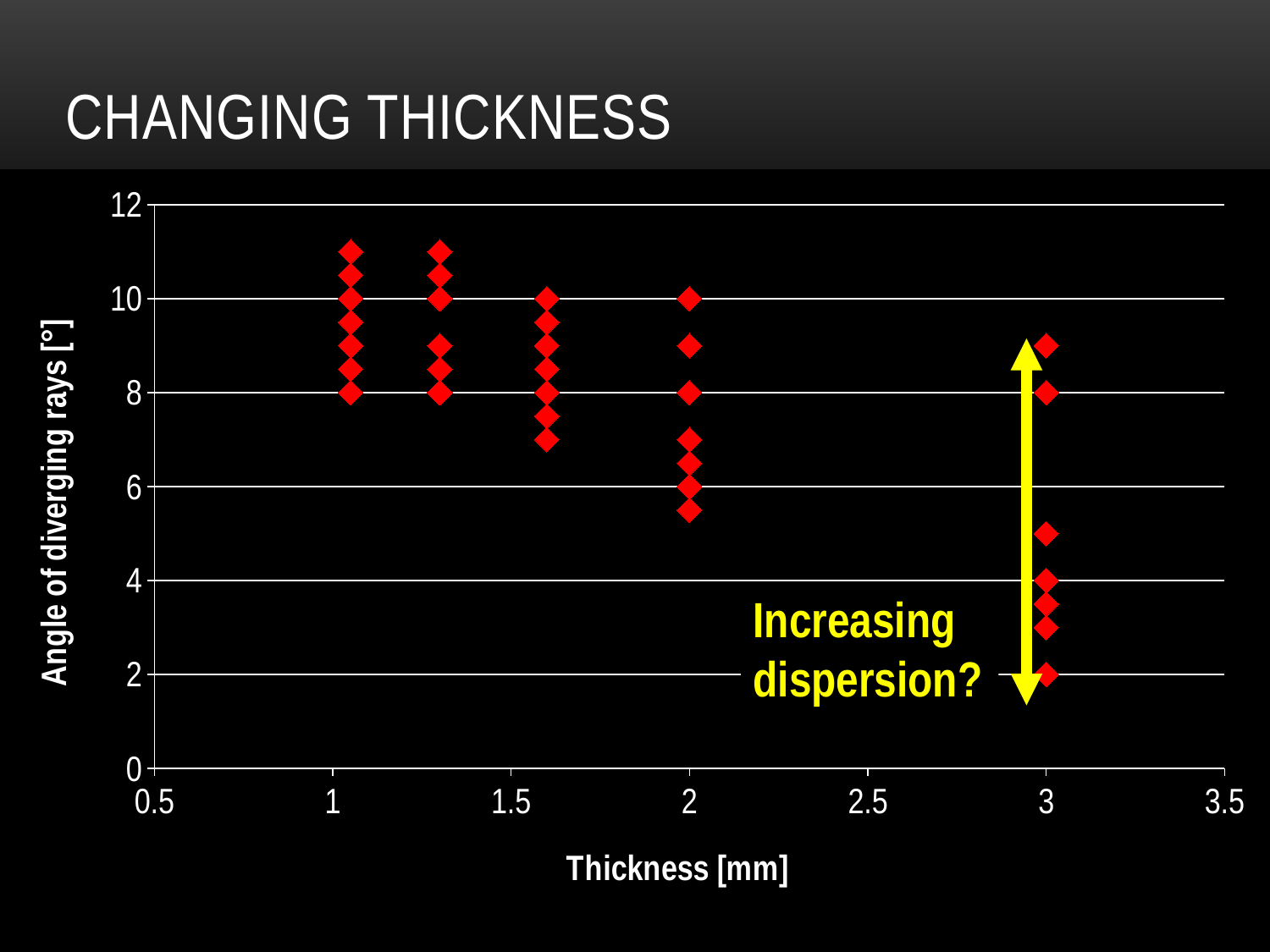
Is the lowest point at a thickness of 3 mm larger or smaller than the lowest point at a thickness of 1 mm? Smaller As thickness increases along the x axis, does the minimum angle of diverging rays rise or fall? Fall Is the lowest point at a thickness of 3 mm greater or less than 6? less Is the highest point at a thickness of 1 mm greater or less than 10? greater Is the lowest point at a thickness of 1.6 mm greater or less than 6? greater What is the title of the y axis of the chart? Angle of diverging rays [°] At which thickness do the plotted points show the widest spread of angles? 3 mm How many distinct thickness values have data points plotted on the chart? 5 What kind of chart is shown on the slide? Scatter chart At which thickness does the lowest plotted angle of diverging rays occur? 3 mm What is the title of the x axis of the chart? Thickness [mm]